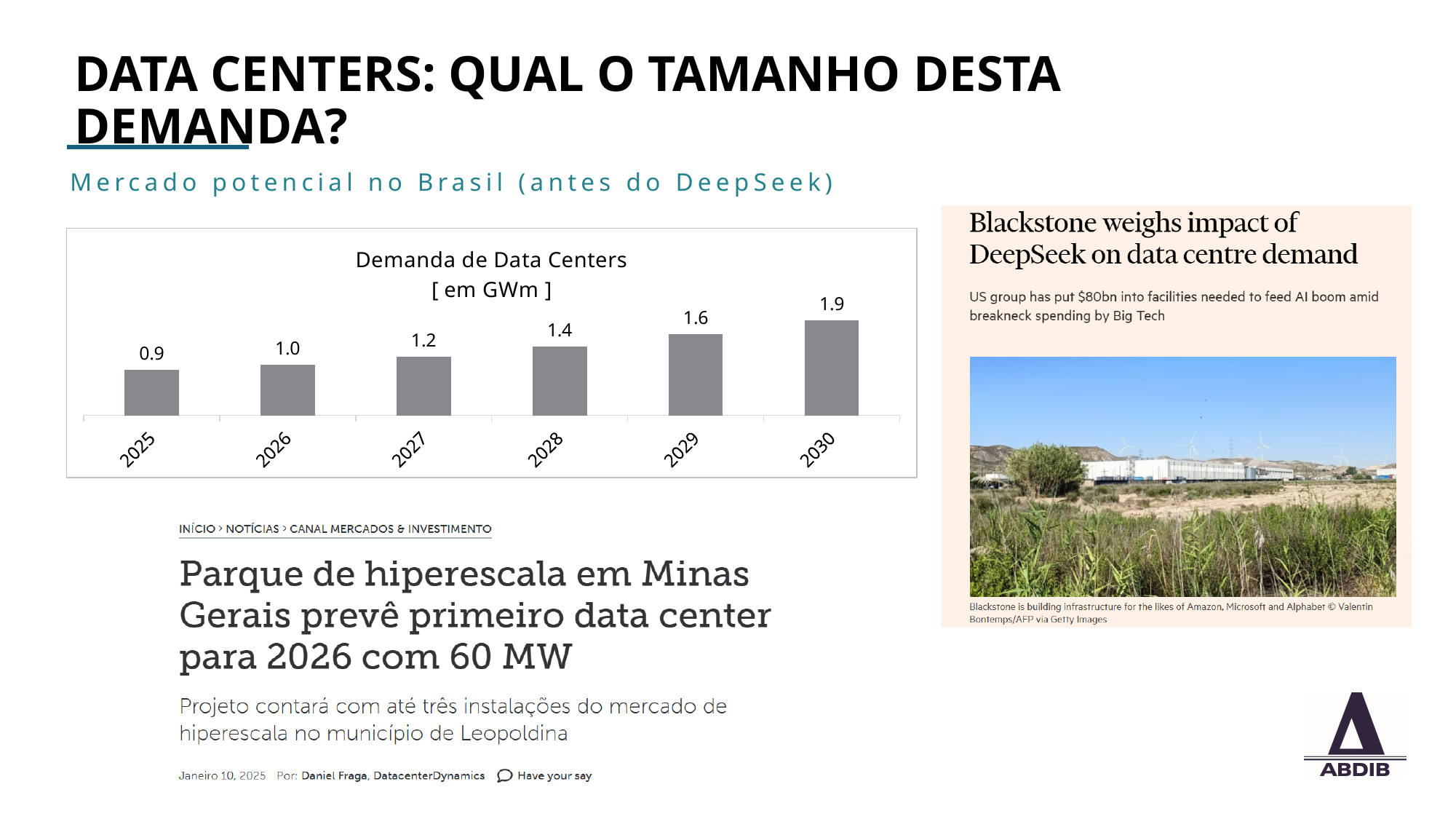
Which year has the highest data center demand in the chart? 2030 What is the difference between the demand values for 2029 and 2027? 0.4 Which year has a larger demand value, 2026 or 2029? 2029 What is the difference between the demand values for 2030 and 2025? 1.0 What unit is given in the chart title for the demand values? GWm Which year has the lowest data center demand in the chart? 2025 Do the demand values rise or fall from 2025 to 2030? Rise What is the data center demand value shown for 2030? 1.9 What is the data center demand value shown for 2025? 0.9 How many years are shown on the x axis of the chart? 6 What kind of chart is used to show the data center demand? Bar chart What is the data center demand value shown for 2028? 1.4